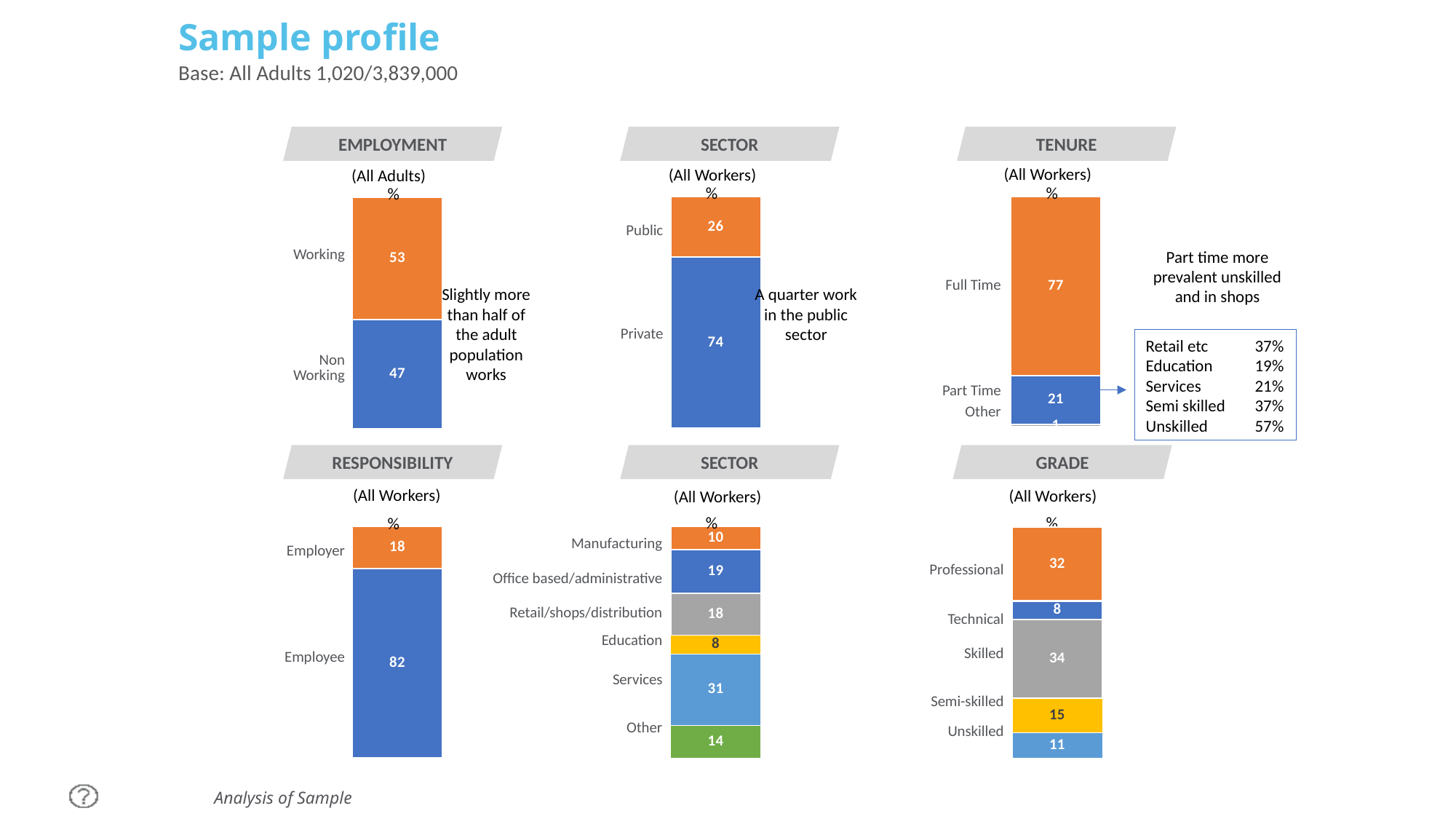
In the GRADE chart, which is larger, Professional or Skilled? Skilled In the TENURE chart, what is the value for Part Time? 21 In the GRADE chart, what is the value for Semi-skilled? 15 In the bottom-middle SECTOR chart, which category has the lowest value? Education In the RESPONSIBILITY chart, what is the difference between Employee and Employer? 64 In the top-middle SECTOR chart (Public/Private), what is the value for Private? 74 In the bottom-middle SECTOR chart, which category has the highest value? Services In the EMPLOYMENT chart, what is the value for Working? 53 In the TENURE chart, what is the total of Full Time, Part Time and Other? 99 What kind of chart is the EMPLOYMENT chart? Stacked bar chart In the GRADE chart, what is the difference between Skilled and Technical? 26 In the bottom-middle SECTOR chart, how many categories are shown? 6